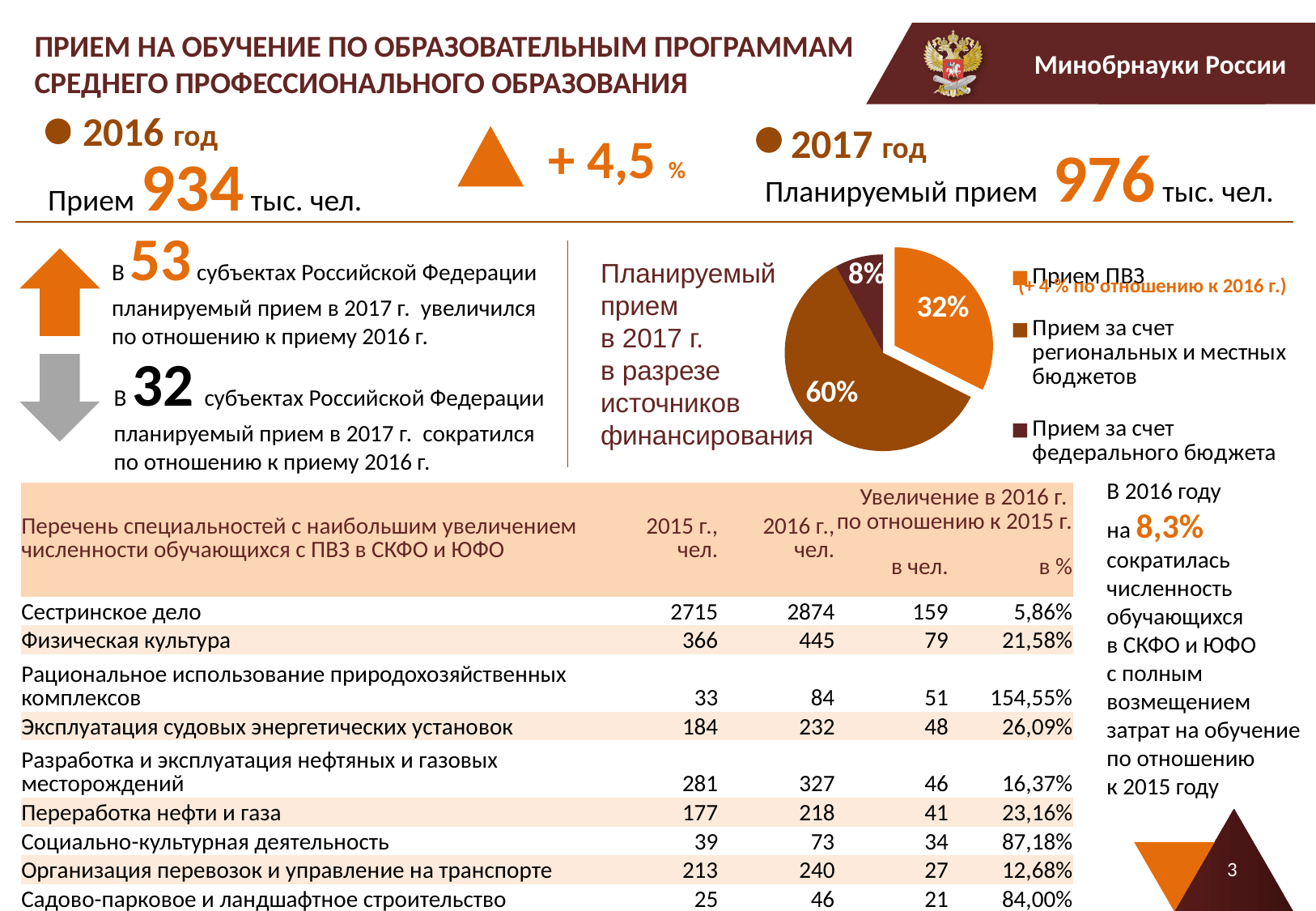
What share of the planned 2017 intake is funded by the federal budget (Прием за счет федерального бюджета)? 8% What kind of chart is shown on the slide? pie chart Which is larger: the Прием ПВЗ slice or the federal budget slice? Прием ПВЗ How many slices does the pie chart have? 3 What is the combined share of the Прием ПВЗ and federal budget slices? 40% What share of the planned 2017 intake is funded by regional and local budgets (Прием за счет региональных и местных бюджетов)? 60% How many entries does the pie chart legend list? 3 Which funding source has the largest slice of the pie chart? Прием за счет региональных и местных бюджетов What does the text next to the pie chart say the chart shows? Планируемый прием в 2017 г. в разрезе источников финансирования What is the difference in percentage points between the regional/local budgets slice and the Прием ПВЗ slice? 28 percentage points What share of the planned 2017 intake is Прием ПВЗ? 32% Which funding source has the smallest slice of the pie chart? Прием за счет федерального бюджета